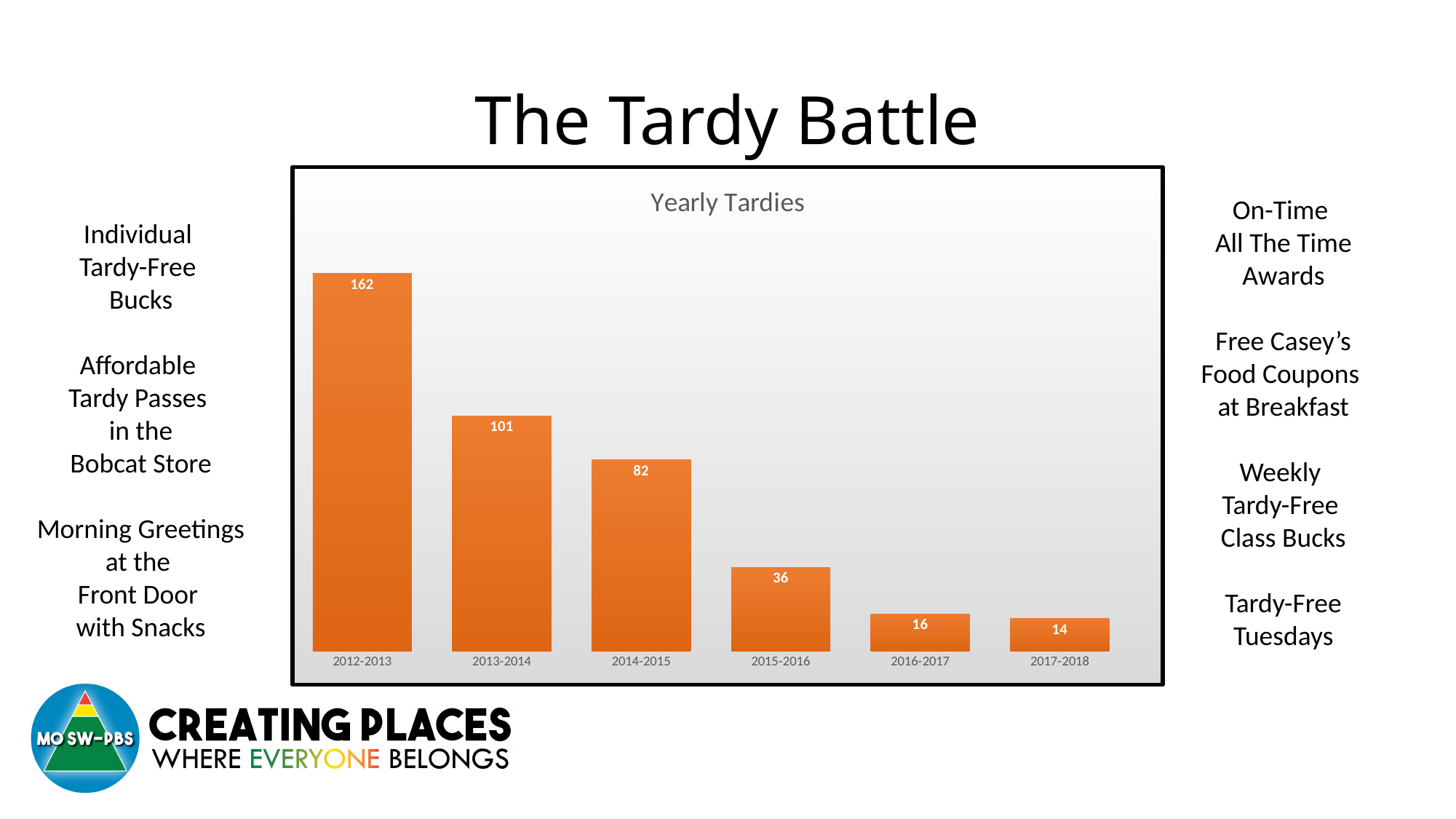
What is the value for 2015-2016 in the Yearly Tardies chart? 36 What is the value for 2012-2013 in the Yearly Tardies chart? 162 Which year has the lowest number of tardies? 2017-2018 Which year has the highest number of tardies? 2012-2013 What kind of chart is shown on the slide? Bar chart What is the value for 2017-2018 in the Yearly Tardies chart? 14 How many school years are shown in the chart? 6 Do the yearly tardies rise or fall from 2012-2013 to 2017-2018? Fall What is the title of the chart? Yearly Tardies What is the difference between the tardies in 2014-2015 and 2015-2016? 46 What is the difference between the tardies in 2012-2013 and 2013-2014? 61 Which year had more tardies, 2013-2014 or 2014-2015? 2013-2014